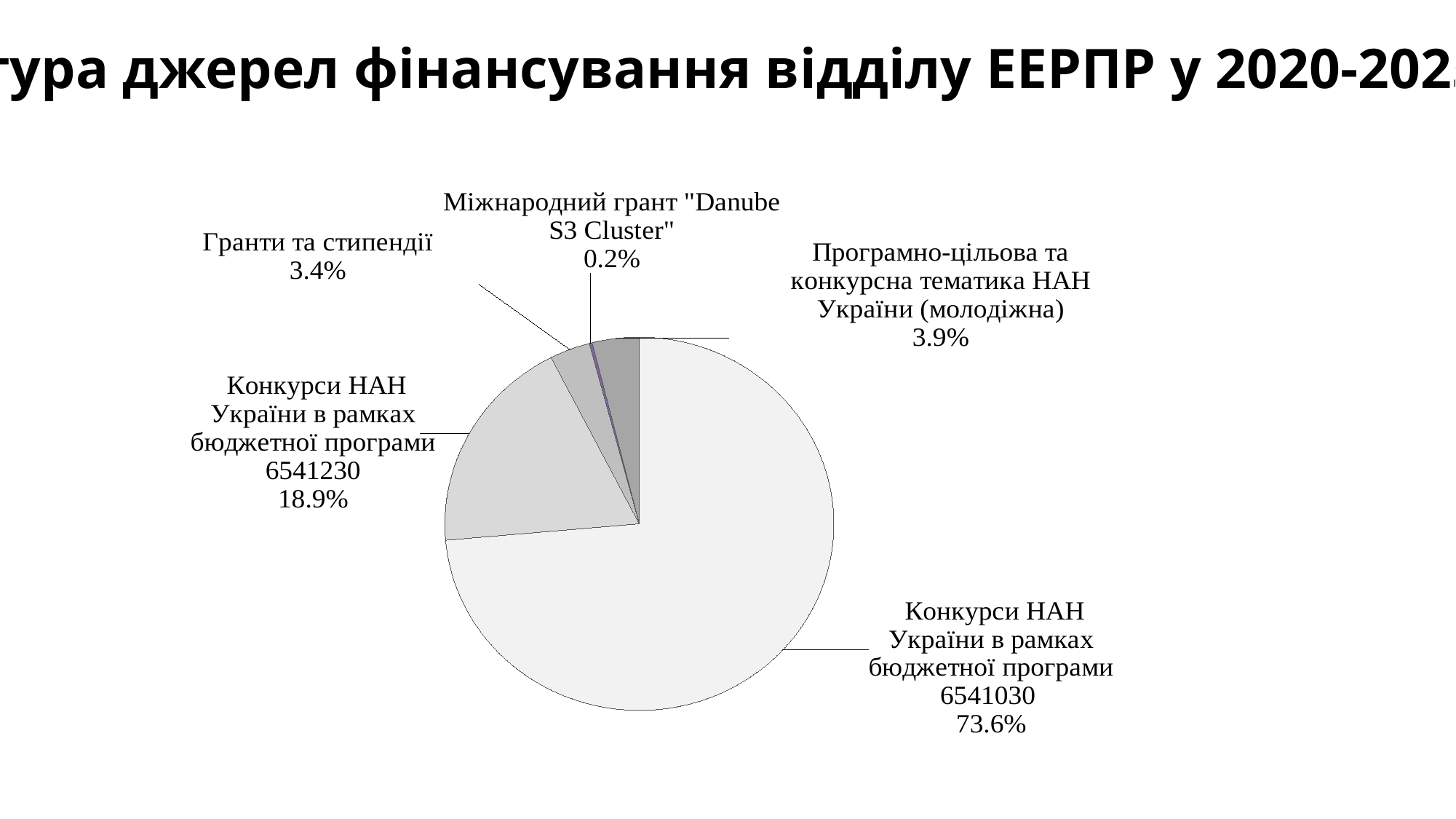
What share of the pie does "Конкурси НАН України в рамках бюджетної програми 6541230" have? 18.9% What percentage is shown for "Гранти та стипендії"? 3.4% What is the difference in percentage points between the 6541030 budget programme slice (73.6%) and the 6541230 budget programme slice (18.9%)? 54.7 What percentage is shown for "Програмно-цільова та конкурсна тематика НАН України (молодіжна)"? 3.9% What share of the pie does "Конкурси НАН України в рамках бюджетної програми 6541030" have? 73.6% What is the combined percentage of the two "Конкурси НАН України в рамках бюджетної програми" slices (6541030 and 6541230)? 92.5% What kind of chart is shown on the slide? pie chart Which slice of the pie chart is the smallest? Міжнародний грант "Danube S3 Cluster" Which slice of the pie chart is the largest? Конкурси НАН України в рамках бюджетної програми 6541030 What percentage is shown for "Міжнародний грант "Danube S3 Cluster""? 0.2% Which is larger: the share for "Гранти та стипендії" or the share for "Програмно-цільова та конкурсна тематика НАН України (молодіжна)"? Програмно-цільова та конкурсна тематика НАН України (молодіжна) How many slices does the pie chart have? 5